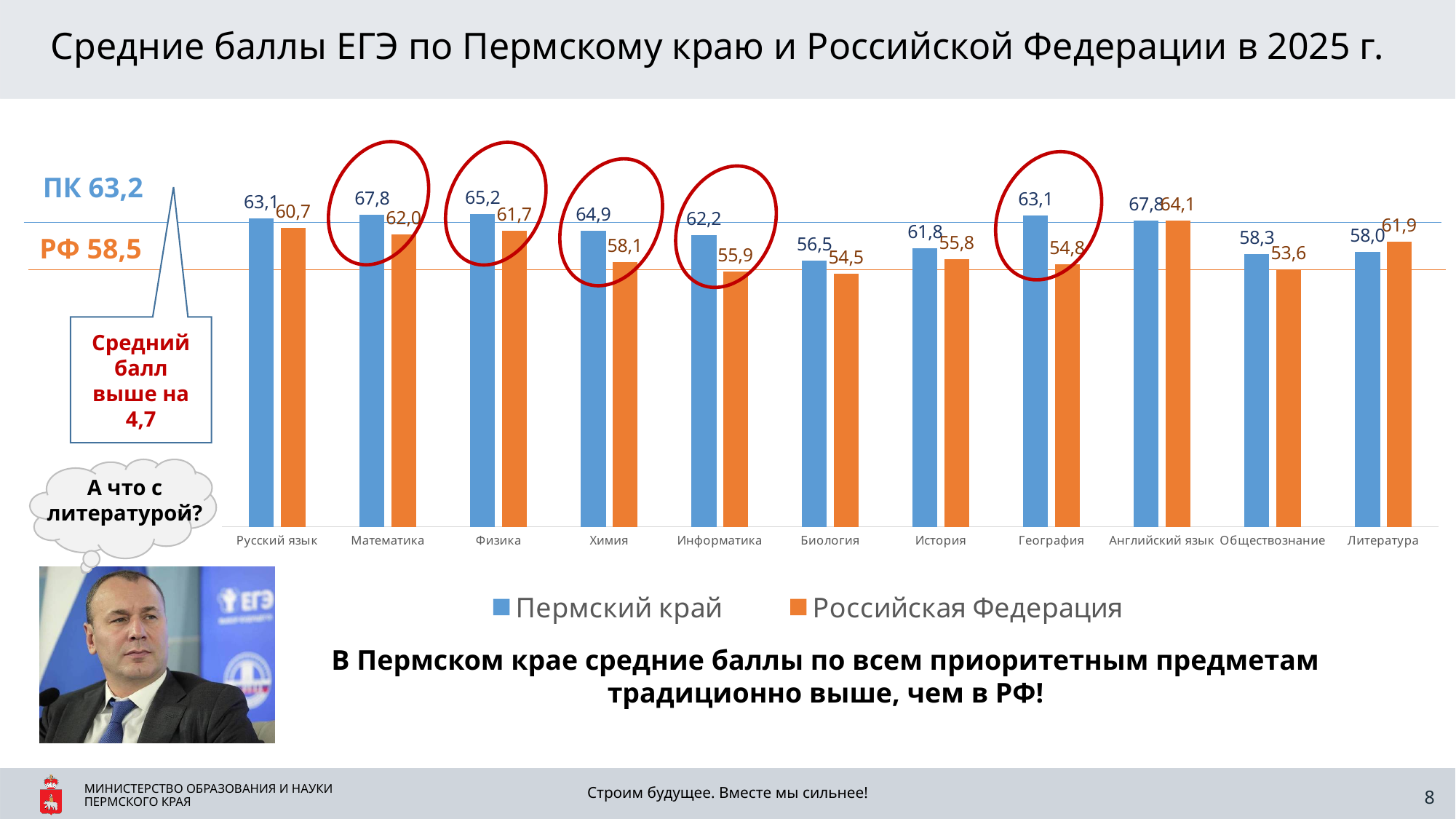
How many subjects are shown on the x axis of the chart? 11 What is the average score for Пермский край in Математика? 67,8 In which subject is the Российская Федерация average score the highest? Английский язык In Литература, which is higher: the Пермский край score or the Российская Федерация score? Российская Федерация What type of chart is shown on the slide? Bar chart What is the average score for Пермский край in Литература? 58,0 What is the difference between the Пермский край and Российская Федерация scores in Математика? 5,8 How many series does the legend list? 2 What is the average score for Российская Федерация in Химия? 58,1 In which subject is the Пермский край average score the lowest? Биология By how much does the Пермский край score exceed the Российская Федерация score in География? 8,3 In which subject is the Российская Федерация average score the lowest? Обществознание